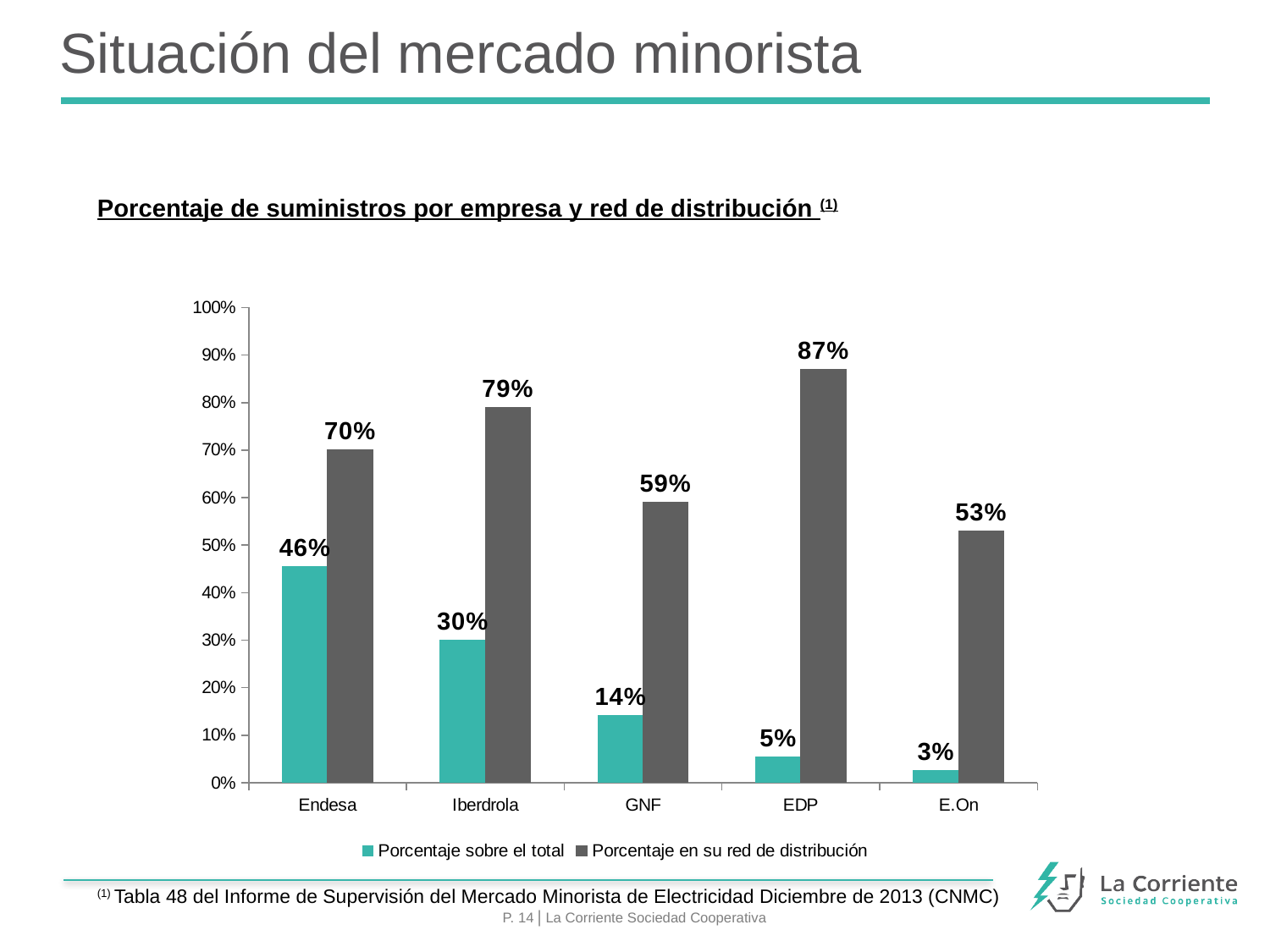
How many companies are shown on the x axis of the chart? 5 What is the 'Porcentaje en su red de distribución' value for E.On? 53% What is the 'Porcentaje en su red de distribución' value for EDP? 87% Which is larger: the 'Porcentaje en su red de distribución' for GNF or for E.On? GNF What kind of chart is shown on the slide? Bar chart Which company has the highest 'Porcentaje en su red de distribución'? EDP Which company has the lowest 'Porcentaje sobre el total'? E.On How many series does the chart legend list? 2 What is the difference between Iberdrola's 'Porcentaje en su red de distribución' and its 'Porcentaje sobre el total'? 49% What is the 'Porcentaje sobre el total' value for Endesa? 46% Is the 'Porcentaje sobre el total' for Iberdrola greater or less than 40%? less What is the title of the chart on the slide? Porcentaje de suministros por empresa y red de distribución